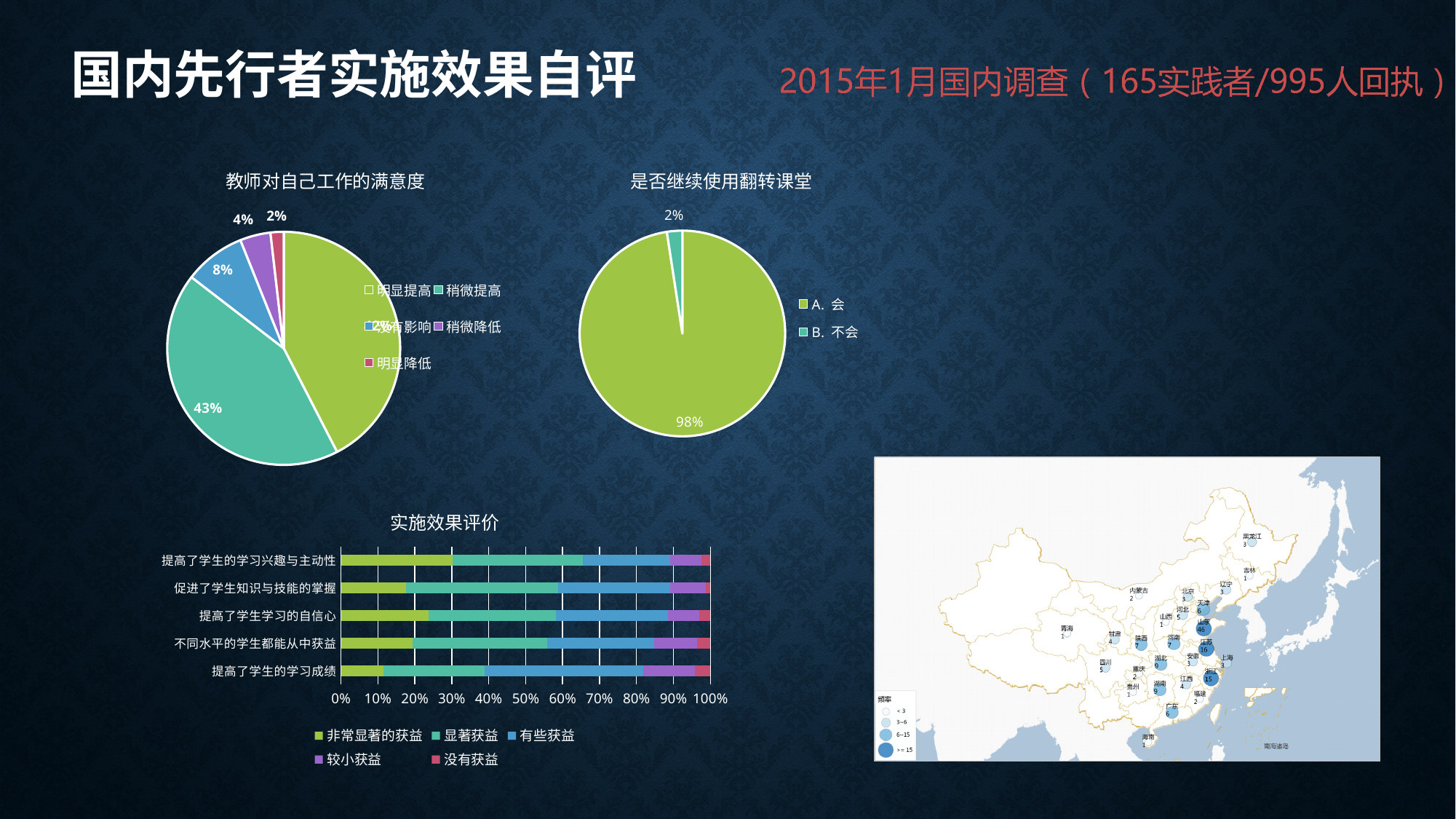
In the pie chart titled 教师对自己工作的满意度, what percentage is shown for 明显降低? 2% In the pie chart titled 教师对自己工作的满意度, what is the difference in percentage points between 稍微提高 and 没有影响? 35% What kind of chart is the chart titled 实施效果评价? Stacked bar chart In the pie chart titled 是否继续使用翻转课堂, which slice is larger, A. 会 or B. 不会? A. 会 In the pie chart titled 是否继续使用翻转课堂, what percentage is shown for A. 会? 98% In the pie chart titled 是否继续使用翻转课堂, what percentage is shown for B. 不会? 2% In the pie chart titled 教师对自己工作的满意度, what percentage is shown for 没有影响? 8% In the pie chart titled 教师对自己工作的满意度, what percentage is shown for 稍微提高? 43% In the chart titled 实施效果评价, is the 非常显著的获益 share for 提高了学生的学习兴趣与主动性 greater or less than 20%? greater In the pie chart titled 教师对自己工作的满意度, what percentage is shown for 稍微降低? 4% How many series does the legend of the chart titled 实施效果评价 list? 5 How many categories are shown in the chart titled 实施效果评价? 5